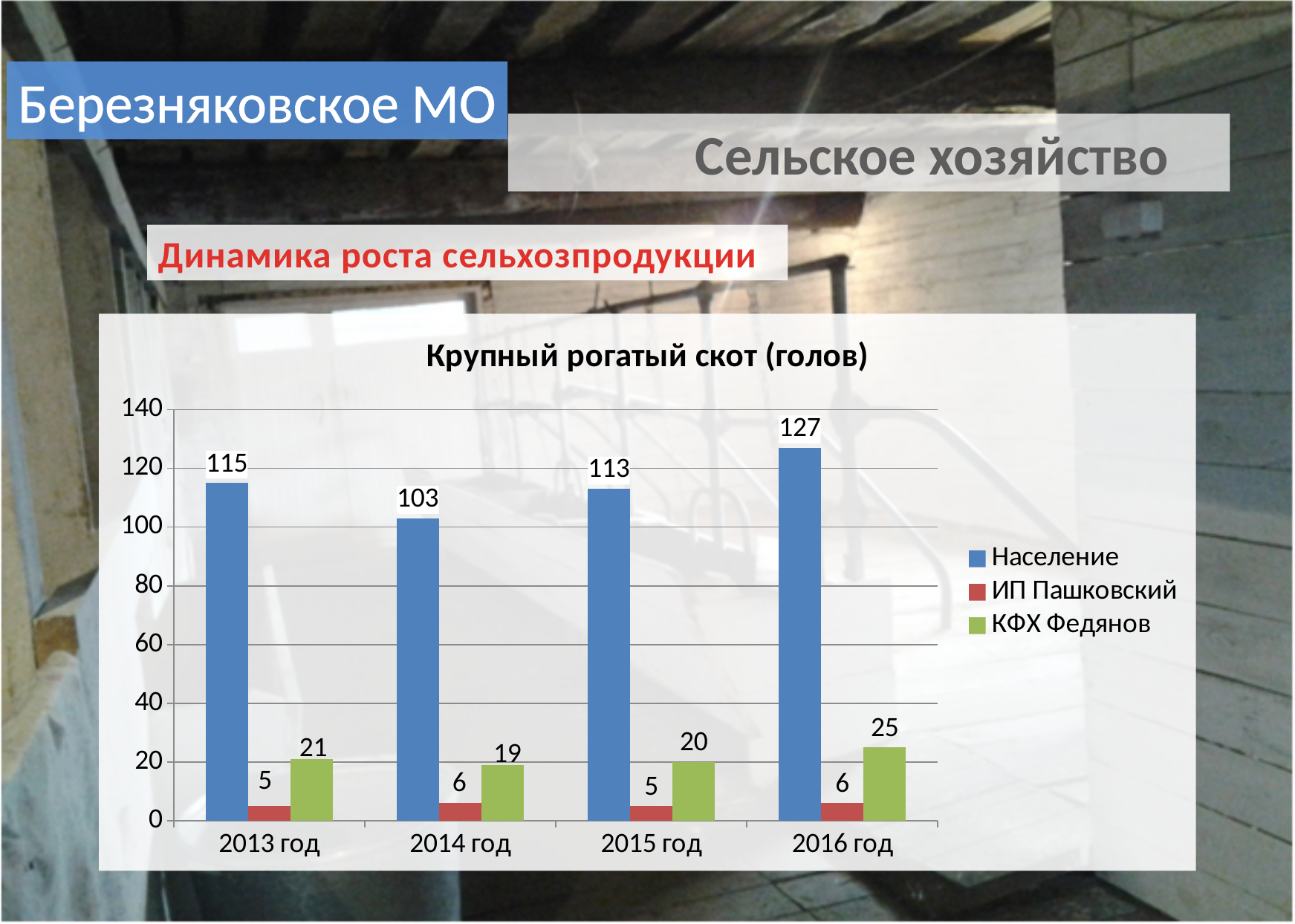
How many series does the legend list? 3 In which year is the Население value the lowest? 2014 год How many years are shown on the x axis? 4 What is the difference between the Население values for 2016 год and 2015 год? 14 What is the title of the chart? Крупный рогатый скот (голов) What kind of chart is shown on the slide? bar chart Which is larger: КФХ Федянов in 2013 год or КФХ Федянов in 2015 год? 2013 год Is the value for Население in 2014 год greater or less than 100? greater What is the value for КФХ Федянов in 2014 год? 19 What is the value for ИП Пашковский in 2015 год? 5 What is the value for Население in 2016 год? 127 In which year is the КФХ Федянов value the highest? 2016 год